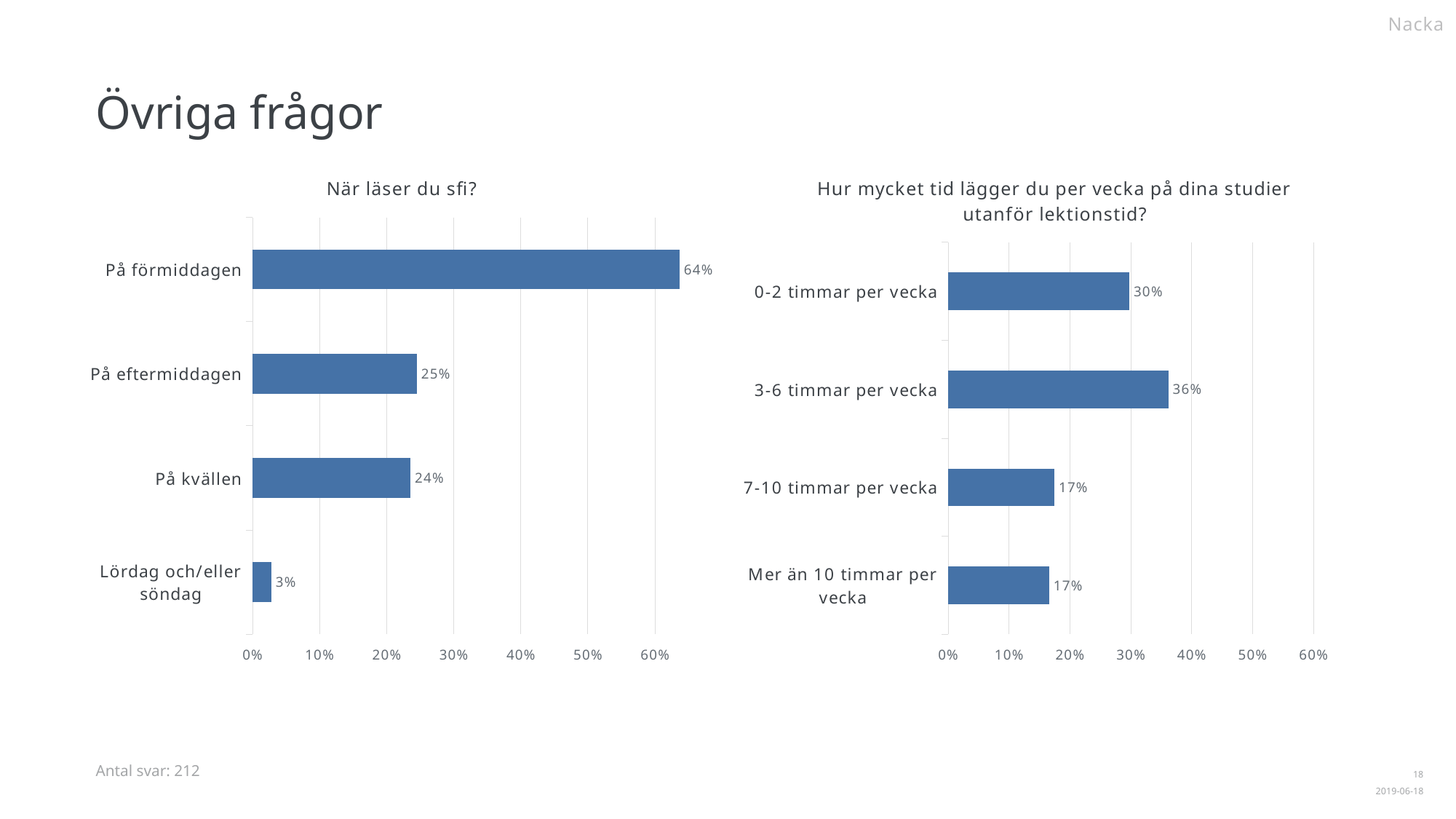
In the chart titled "När läser du sfi?", how many categories are shown? 4 In the chart titled "När läser du sfi?", is the value for "På kvällen" greater or less than 30%? less In the chart titled "När läser du sfi?", what is the difference between "På förmiddagen" and "På eftermiddagen"? 39% In the chart titled "Hur mycket tid lägger du per vecka på dina studier utanför lektionstid?", what is the difference between "3-6 timmar per vecka" and "0-2 timmar per vecka"? 6% In the chart titled "Hur mycket tid lägger du per vecka på dina studier utanför lektionstid?", what is the value for "3-6 timmar per vecka"? 36% In the chart titled "Hur mycket tid lägger du per vecka på dina studier utanför lektionstid?", which category has the highest value? 3-6 timmar per vecka In the chart titled "När läser du sfi?", which category has the lowest value? Lördag och/eller söndag What is the title of the chart on the left of the slide? När läser du sfi? In the chart titled "Hur mycket tid lägger du per vecka på dina studier utanför lektionstid?", which is larger: "0-2 timmar per vecka" or "7-10 timmar per vecka"? 0-2 timmar per vecka What kind of chart is the chart on the right of the slide? Bar chart In the chart titled "När läser du sfi?", what is the value for "På förmiddagen"? 64% In the chart titled "Hur mycket tid lägger du per vecka på dina studier utanför lektionstid?", what is the value for "Mer än 10 timmar per vecka"? 17%